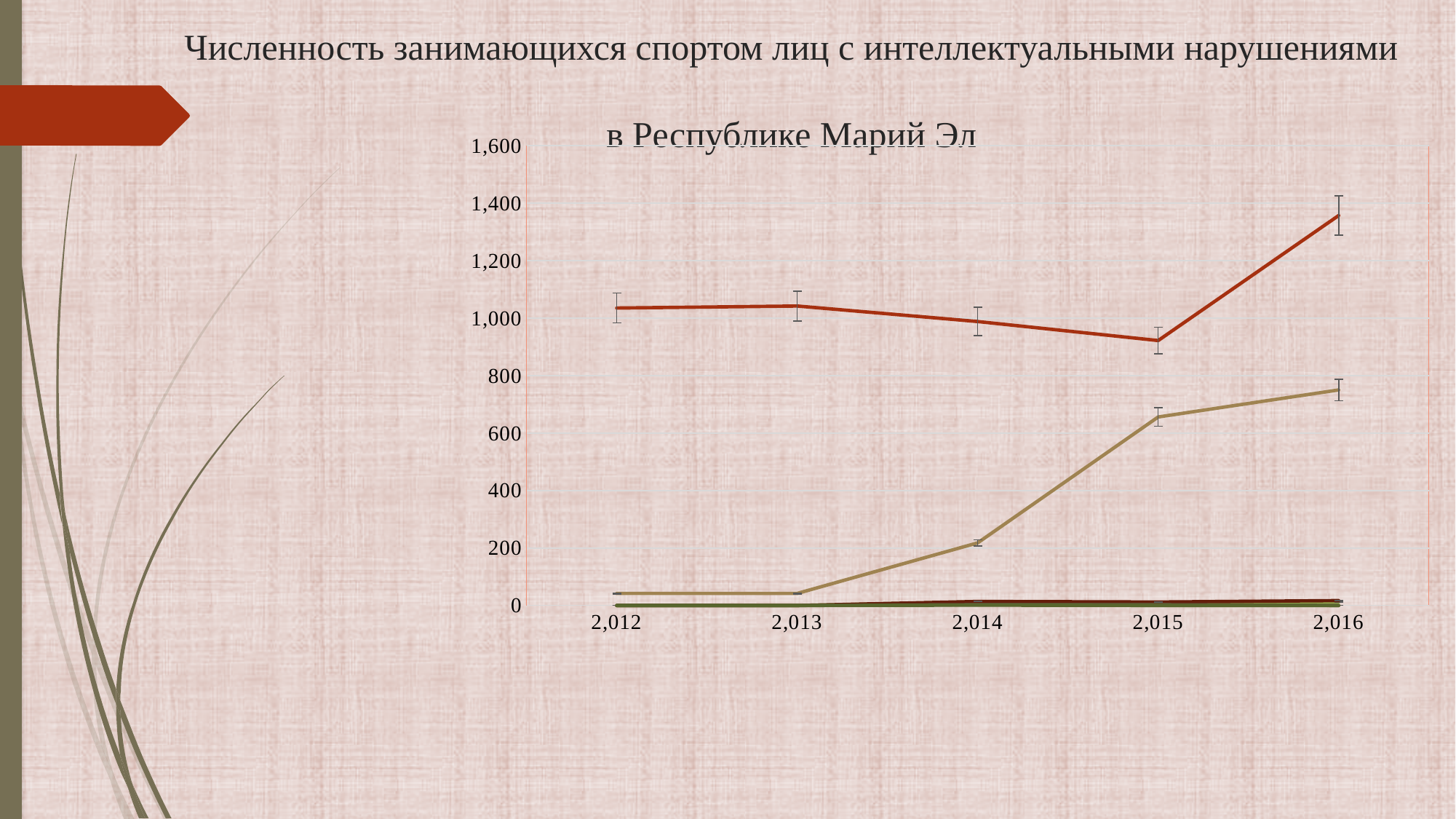
Which line has the larger value in 2,012, the red line or the tan line? the red line In which year does the red line reach its lowest value? 2,015 What kind of chart is shown on the slide? line chart Is the value of the tan line for 2,016 greater or less than 800? less Is the value of the red line for 2,015 greater or less than 1,000? less How many years are shown along the x axis of the chart? 5 What is the title of the chart? Численность занимающихся спортом лиц с интеллектуальными нарушениями в Республике Марий Эл Is the value of the tan line for 2,013 greater or less than 200? less In which year does the red line reach its highest value? 2,016 What is the first year shown on the x axis? 2,012